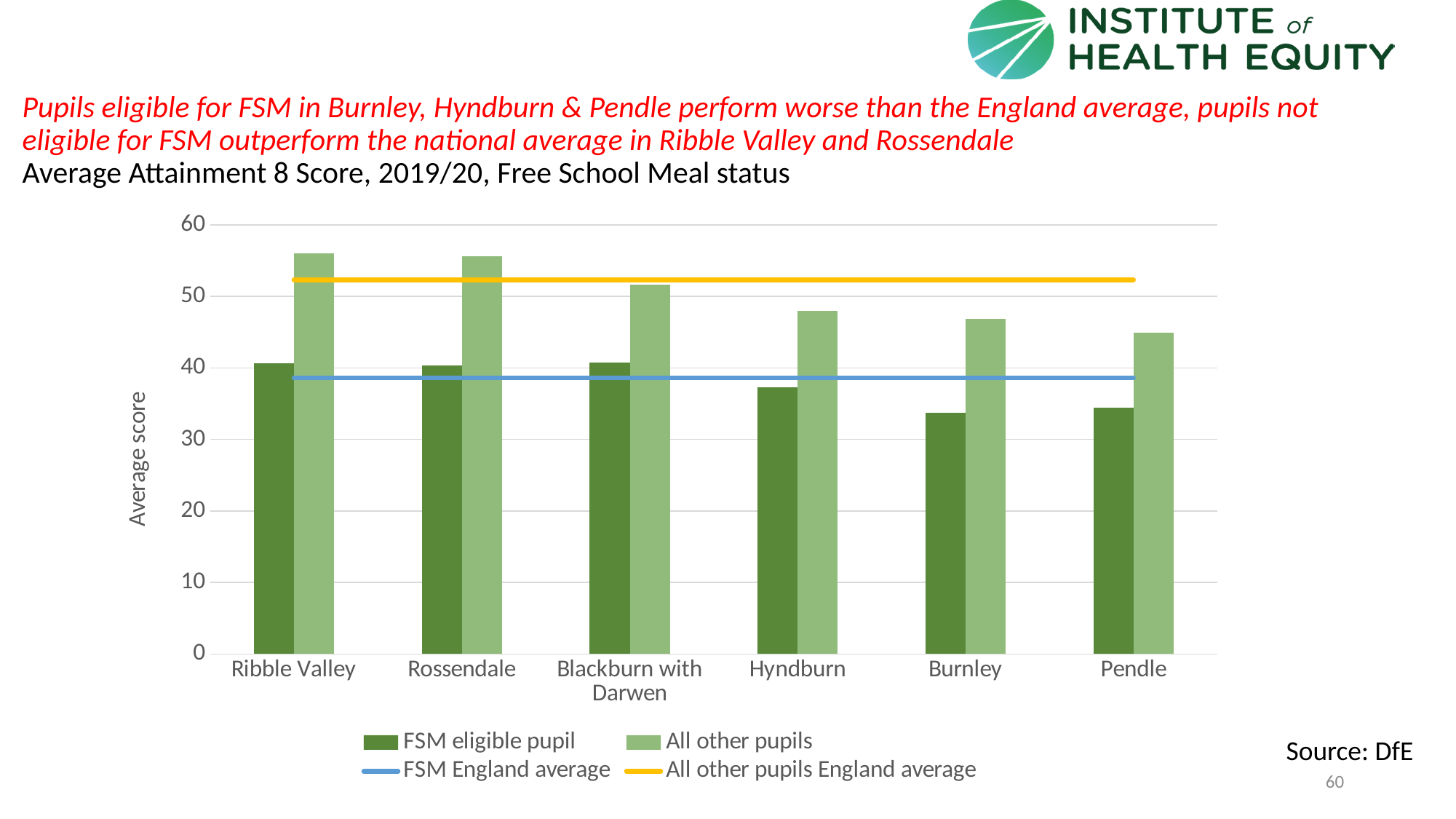
Is the FSM eligible pupil value for Burnley greater or less than 40? less Is the All other pupils value for Ribble Valley greater or less than 50? greater Which area has the lowest value for All other pupils? Pendle Is the FSM eligible pupil value for Hyndburn greater or less than 40? less What is the label on the vertical axis? Average score How many local authority areas are shown on the x axis? 6 Do the All other pupils values generally rise or fall moving from left to right along the x axis? Fall How many entries does the legend list? 4 Which is larger: the FSM eligible pupil value for Ribble Valley or for Burnley? Ribble Valley What kind of chart is shown on the slide? Combination bar and line chart Which is larger: the All other pupils value for Hyndburn or for Pendle? Hyndburn